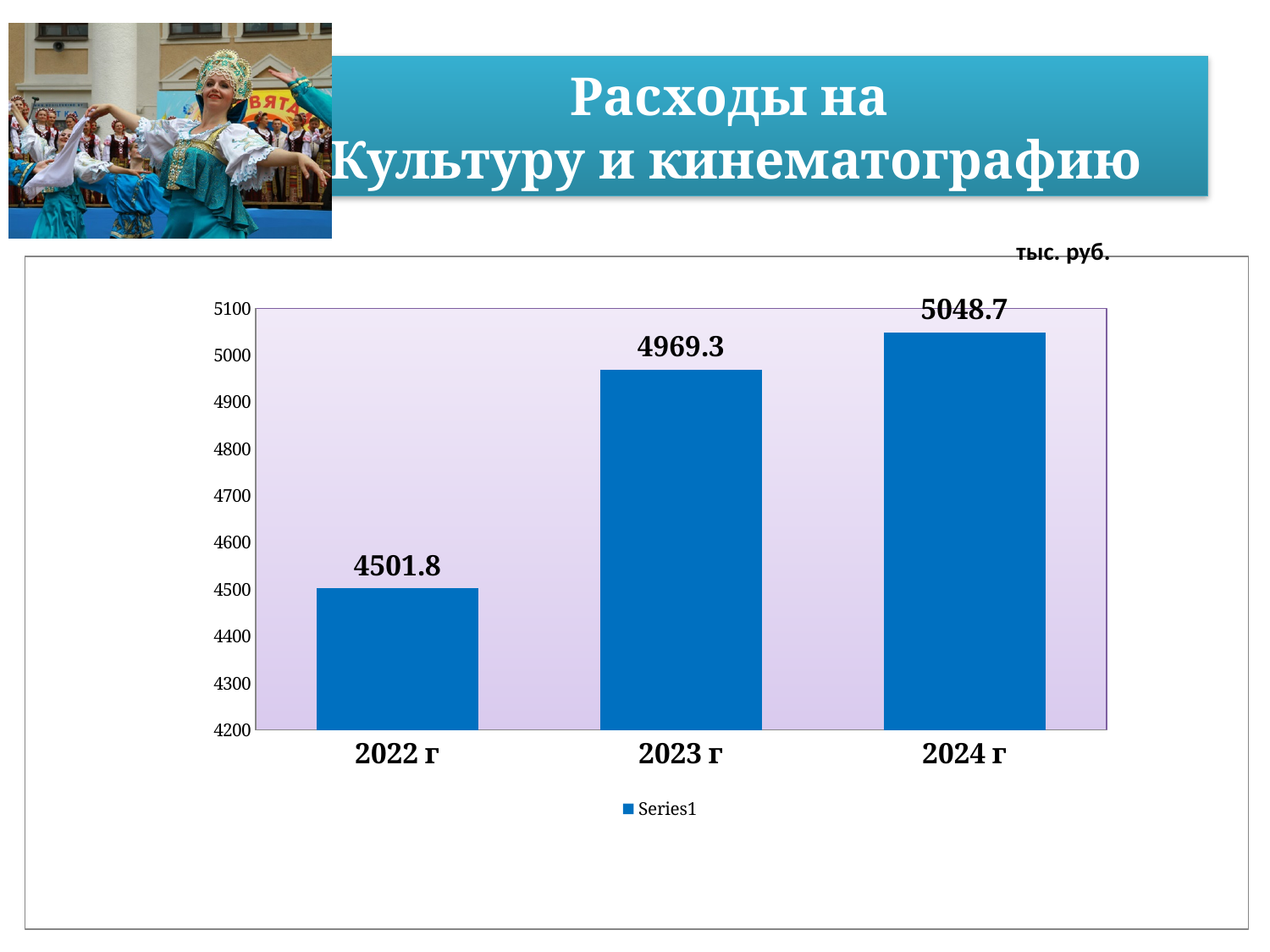
Which year has the highest value? 2024 г Is the value for 2022 г greater or less than 4600? less Which year has the lowest value? 2022 г What is the difference between the values for 2024 г and 2022 г? 546.9 What is the value for 2023 г? 4969.3 What is the value for 2024 г? 5048.7 What is the value for 2022 г? 4501.8 How many years are shown on the chart? 3 What kind of chart is shown on the slide? bar chart Which is larger, the value for 2023 г or the value for 2024 г? 2024 г Do the values rise or fall from 2022 г to 2024 г? rise What is the difference between the values for 2023 г and 2022 г? 467.5